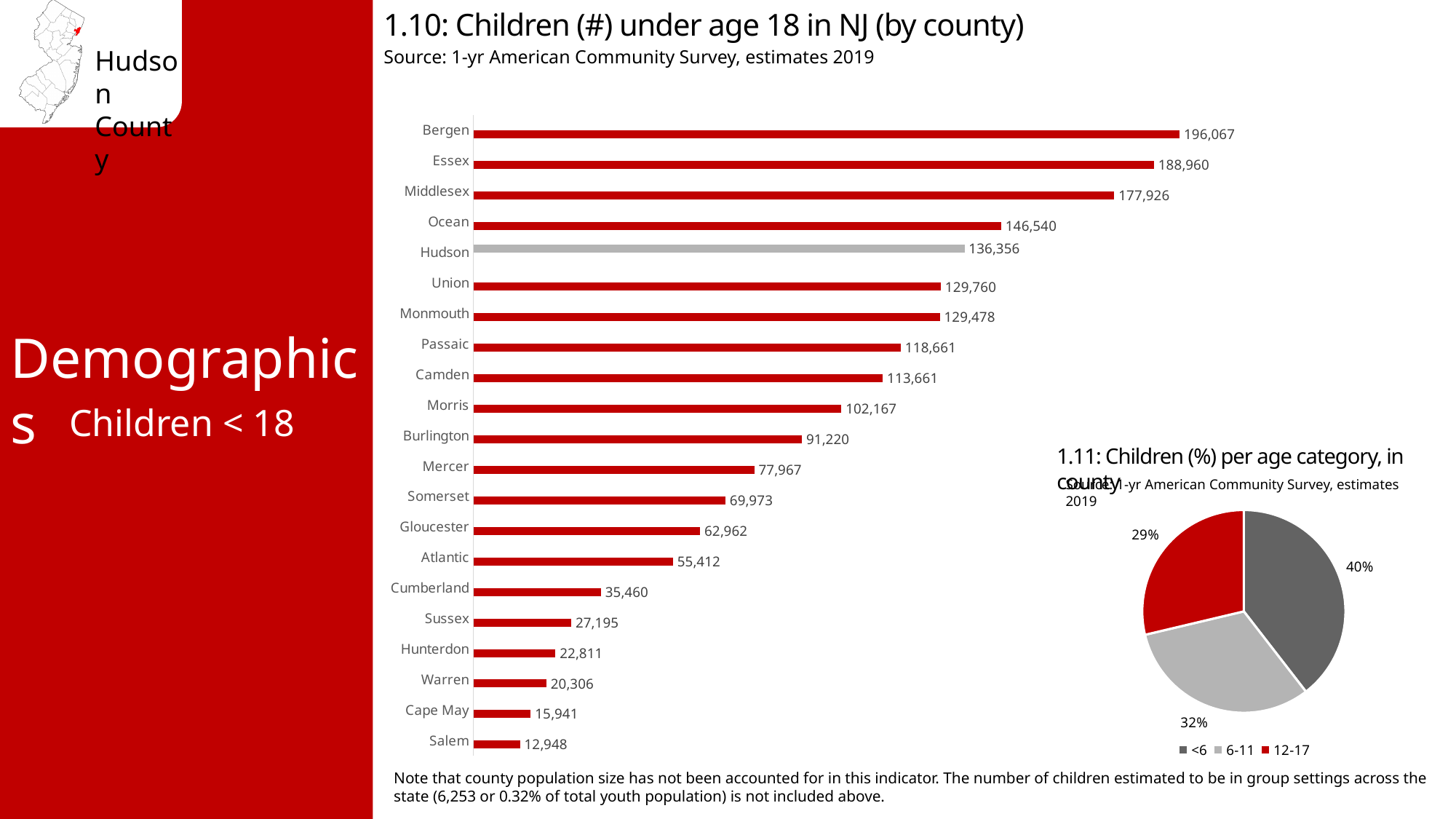
In chart 1.10, which has more children under 18, Passaic or Camden? Passaic In chart 1.10, what is the value for Ocean County? 146,540 In chart 1.10, which county has the highest number of children under age 18? Bergen In chart 1.10, which county's bar is shown in grey instead of red? Hudson In chart 1.10, how many children under age 18 are in Hudson County? 136,356 In chart 1.10, what is the difference between Bergen and Essex? 7,107 How many categories does the legend of chart 1.11 list? 3 In chart 1.11, what share of children are under age 6? 40% In chart 1.10, which county has the lowest number of children under age 18? Salem In chart 1.11, what share of children are aged 12-17? 29% In chart 1.10, how many counties are shown? 21 What kind of chart is chart 1.10? Bar chart